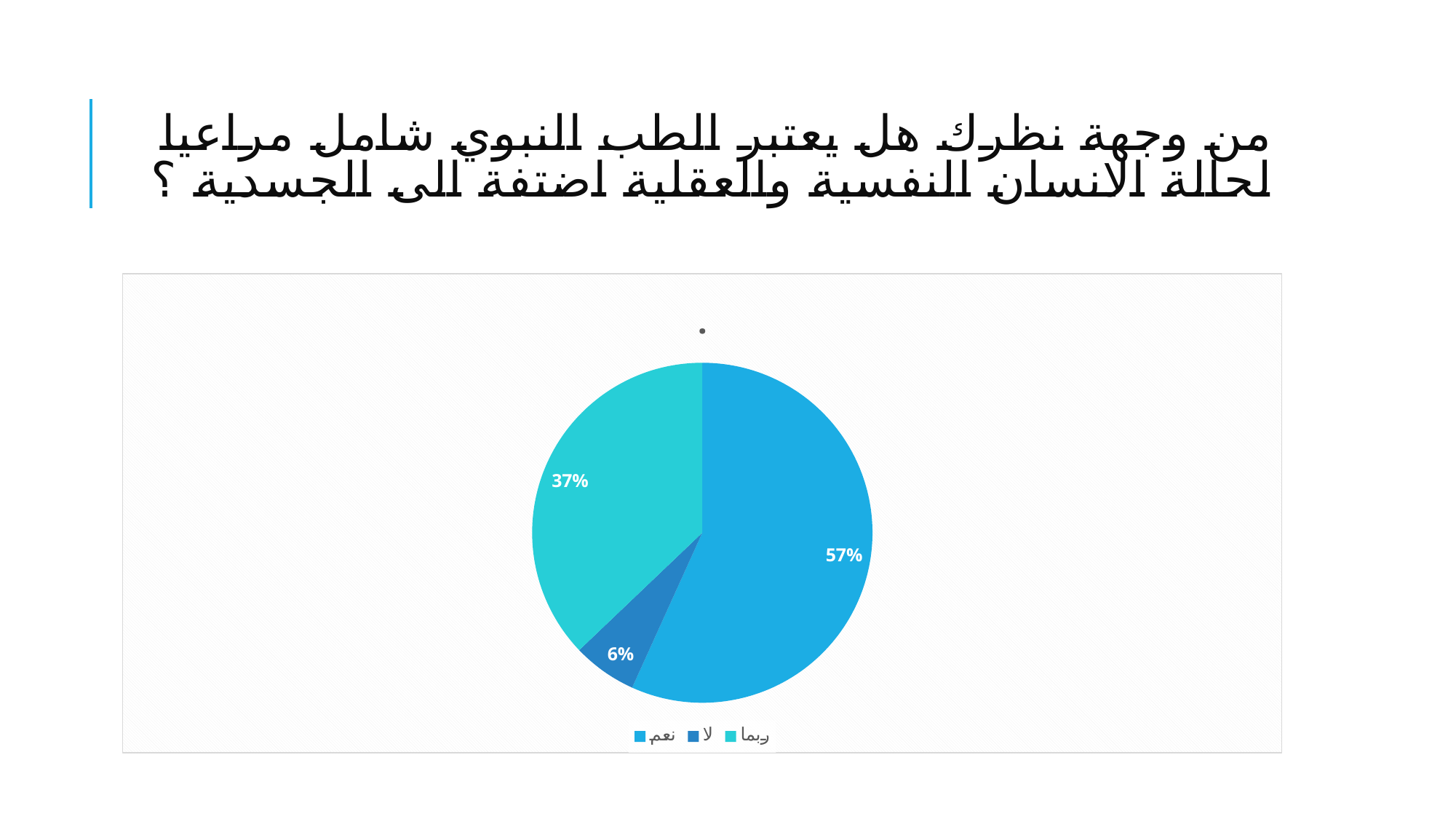
What is the difference in percentage points between the "ربما" and "لا" slices? 31 Which slice is larger, "ربما" or "لا"? ربما Which category has the smallest slice of the pie? لا What share of the pie does the "ربما" slice represent? 37% Which legend entry is shown in the darkest blue colour? لا How many entries does the legend list? 3 Which category has the largest slice of the pie? نعم How many slices does the pie chart have? 3 What share of the pie does the "نعم" slice represent? 57% What is the difference in percentage points between the "نعم" and "ربما" slices? 20 What share of the pie does the "لا" slice represent? 6% What kind of chart is shown on the slide? Pie chart